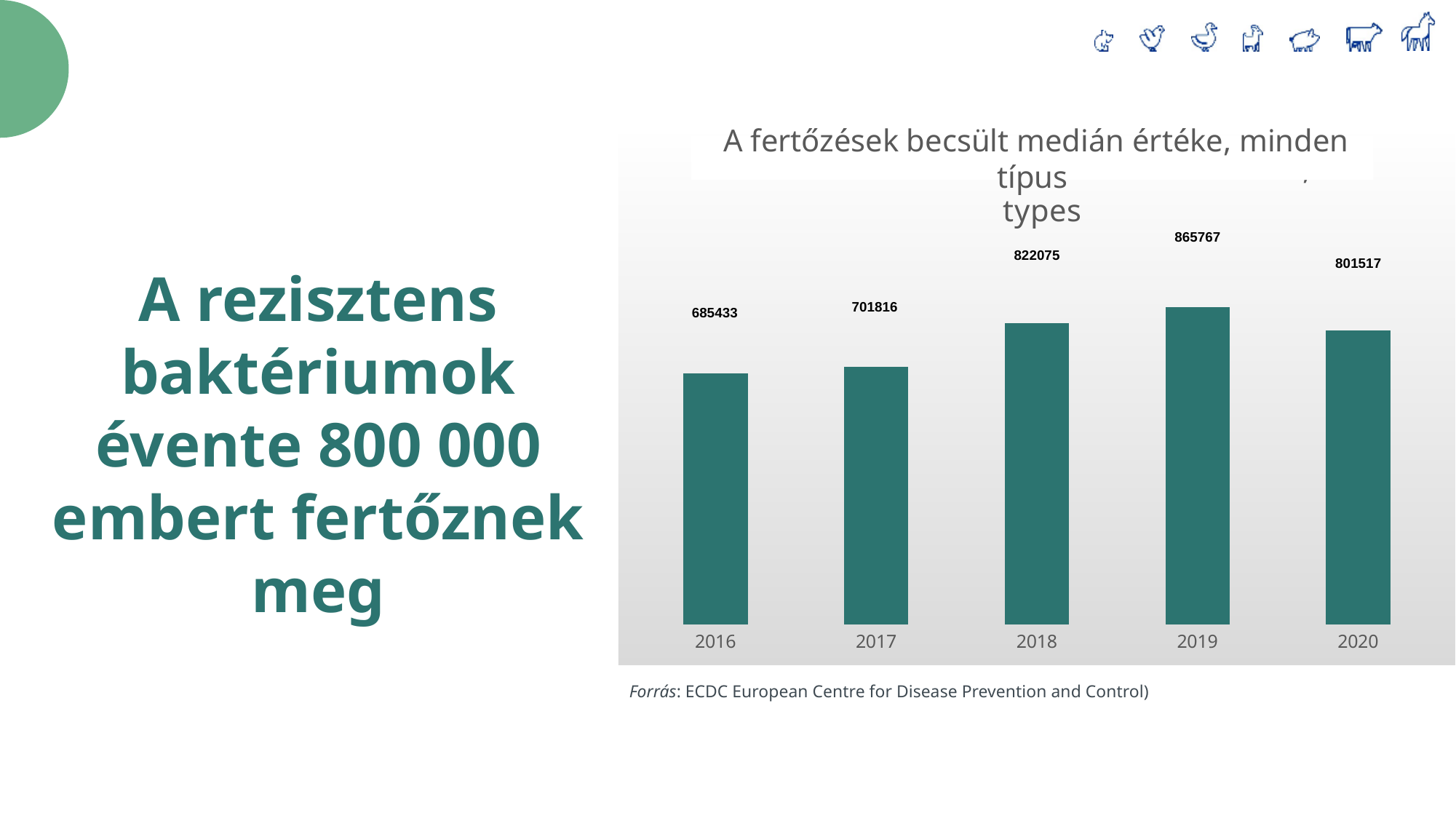
How many years are shown on the x axis? 5 Which year has the highest value? 2019 Which year has the lowest value? 2016 Do the values rise or fall from 2016 to 2019? rise What is the difference between the values for 2018 and 2017? 120259 What is the value for 2018? 822075 Which is larger, the value for 2019 or the value for 2020? 2019 What is the difference between the values for 2019 and 2016? 180334 What is the value for 2020? 801517 What kind of chart is shown on the slide? bar chart What source is cited below the chart? ECDC European Centre for Disease Prevention and Control What is the value for 2016? 685433